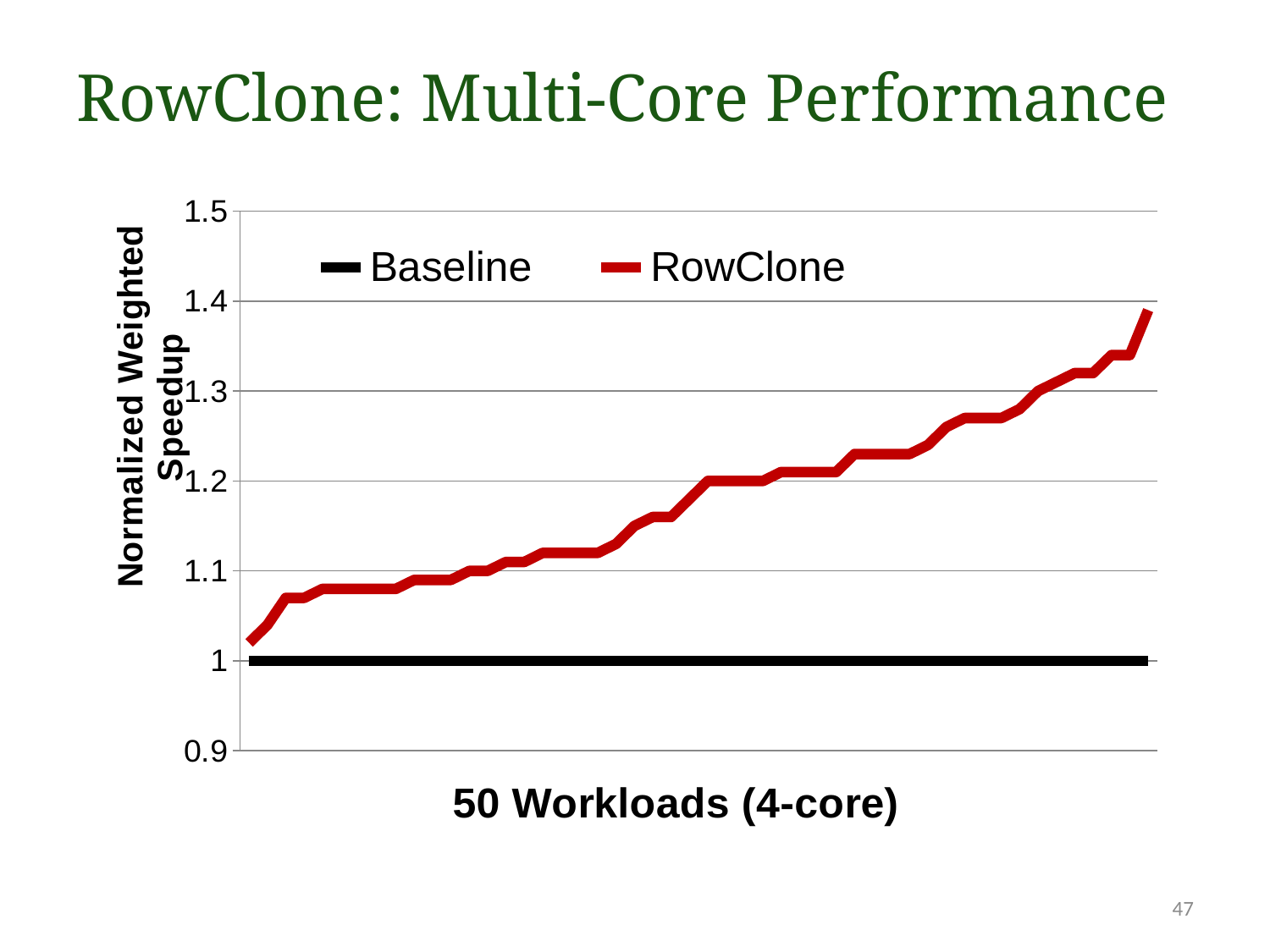
How many series does the legend list? 2 What are the two series named in the legend? Baseline and RowClone What is the title of the chart's x axis? 50 Workloads (4-core) What is the value of the Baseline series across the workloads? 1 Does the RowClone series rise or fall from left to right along the x axis? rise Is the lowest RowClone value greater or less than 1.1? less Which series is drawn in red? RowClone How many workloads are plotted along the x axis? 50 Which series has the higher values across the workloads, Baseline or RowClone? RowClone Is the highest RowClone value greater or less than 1.3? greater What kind of chart is shown on the slide? line chart